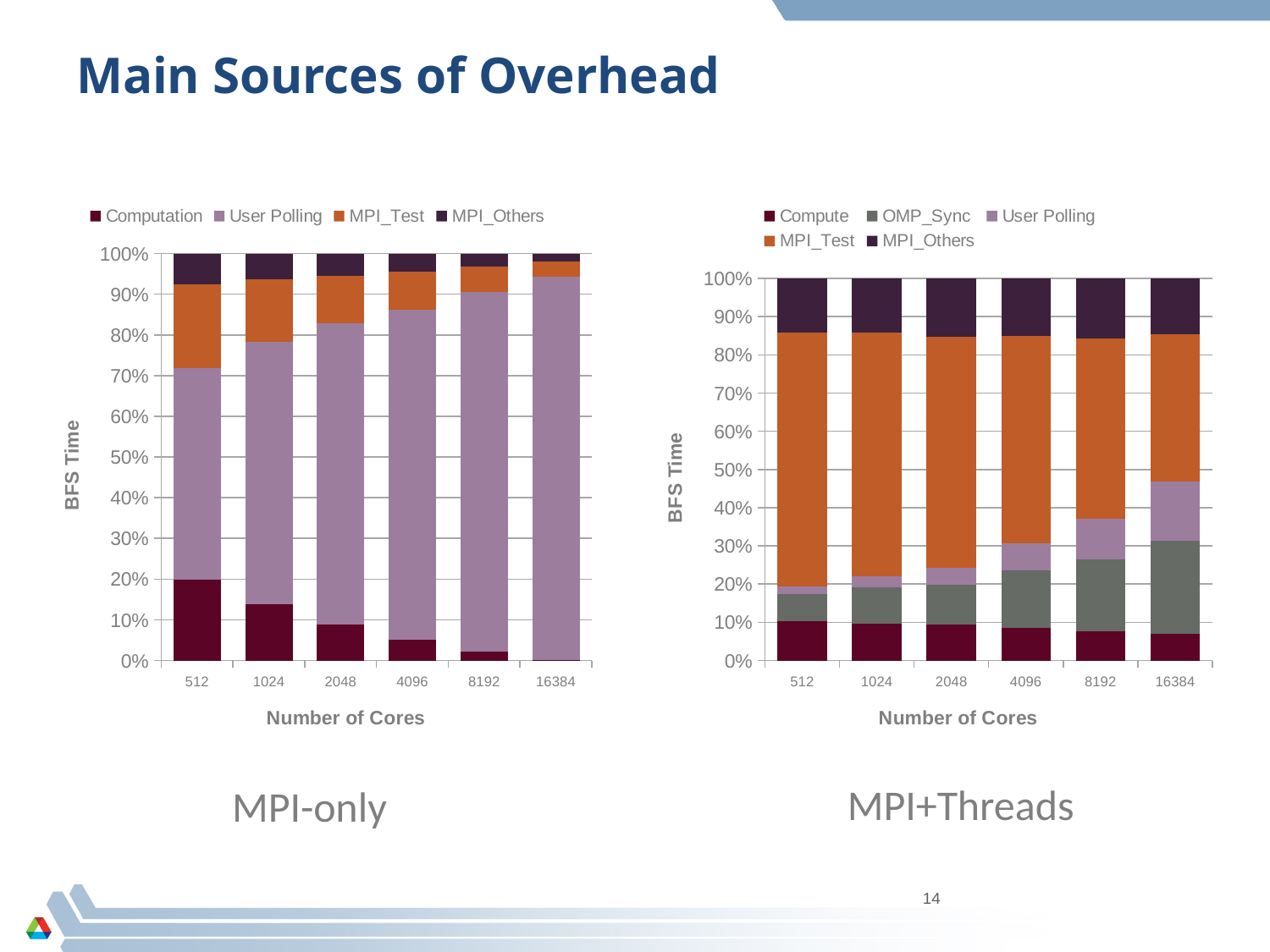
In the MPI+Threads chart, does the OMP_Sync share rise or fall as the number of cores increases? rise How many core counts are shown on the x axis of the MPI+Threads chart? 6 What is the x-axis title of the MPI-only chart? Number of Cores In the MPI-only chart, does the Computation share rise or fall as the number of cores increases? fall In the MPI+Threads chart, is the Compute value for 512 cores greater or less than 20%? less What is the y-axis title of the MPI+Threads chart? BFS Time In the MPI-only chart, is the Computation value for 8192 cores greater or less than 10%? less In the MPI-only chart, does the User Polling share rise or fall as the number of cores increases? rise How many series does the legend of the MPI-only chart list? 4 What kind of chart is the MPI-only chart on the left? Stacked bar chart In the MPI-only chart, is the Computation value for 512 cores greater or less than 10%? greater How many series does the legend of the MPI+Threads chart list? 5